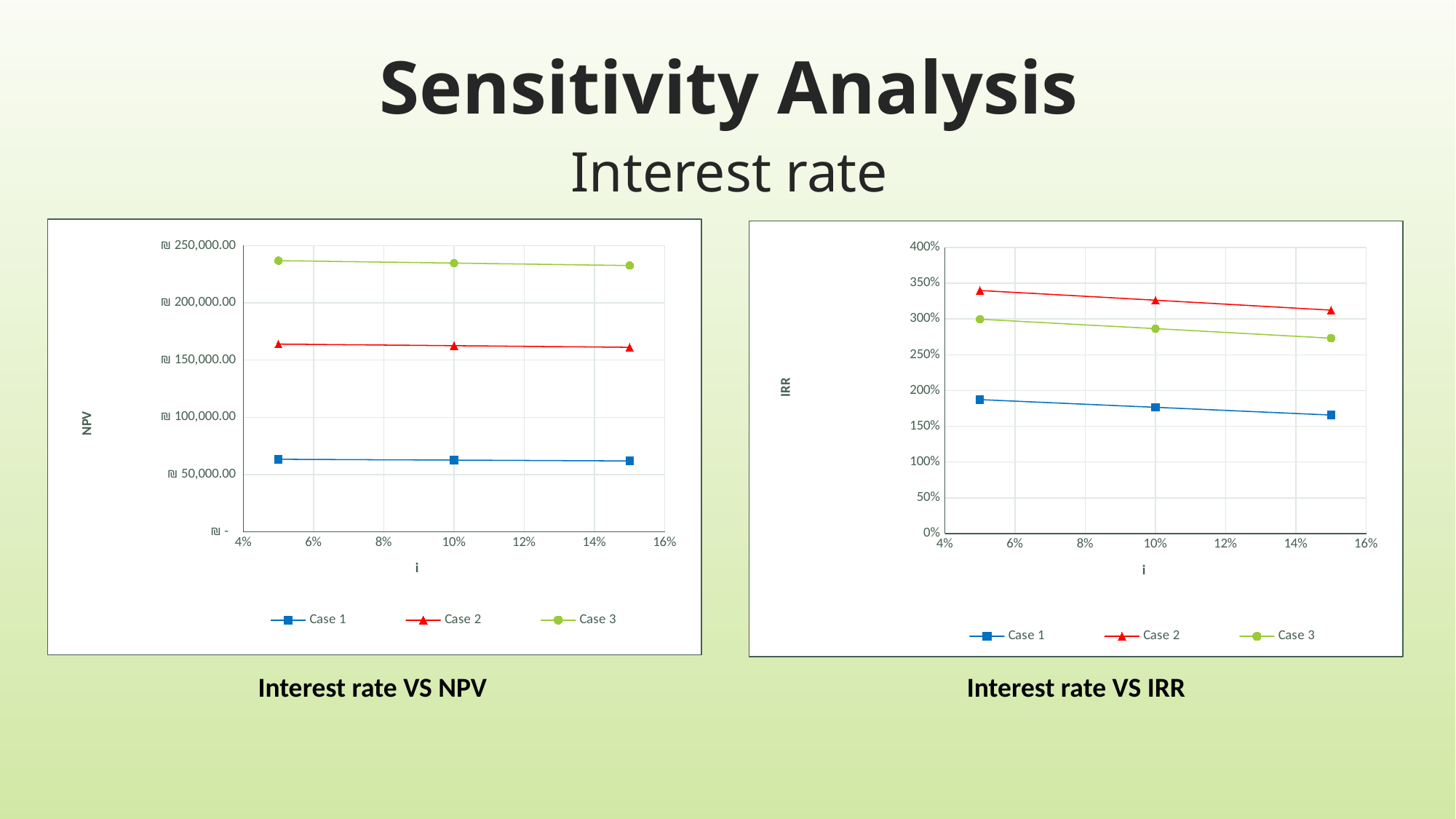
In the Interest rate VS IRR chart, does the IRR for Case 3 rise or fall as the interest rate increases? fall In the Interest rate VS IRR chart, is the IRR for Case 1 at 15% greater or less than 200%? less In the Interest rate VS NPV chart, is the NPV for Case 3 at 5% greater or less than ₪ 200,000.00? greater How many series does the legend of the Interest rate VS IRR chart list? 3 What kind of chart is the Interest rate VS NPV chart? line chart In the Interest rate VS IRR chart, which is larger at 10%: the IRR for Case 2 or Case 3? Case 2 In the Interest rate VS IRR chart, which case has the highest IRR? Case 2 In the Interest rate VS NPV chart, how many data points are plotted for Case 1? 3 In the Interest rate VS NPV chart, which case has the highest NPV? Case 3 In the Interest rate VS NPV chart, is the NPV for Case 1 at 10% greater or less than ₪ 100,000.00? less In the Interest rate VS IRR chart, which case has the lowest IRR? Case 1